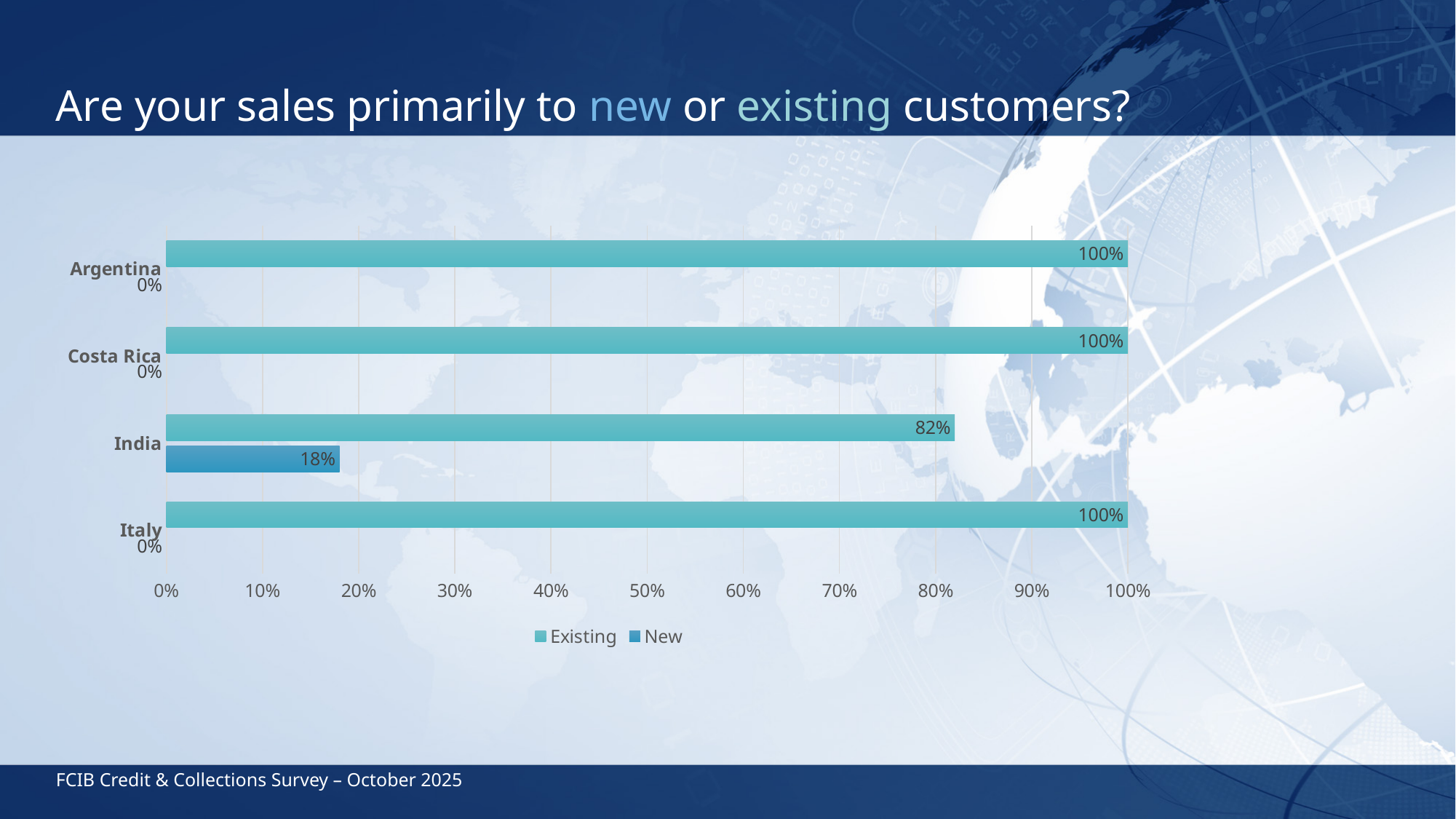
What is the Existing value for India? 82% What is the Existing value for Argentina? 100% What are the two series named in the legend? Existing and New Which country has the lowest Existing value? India What kind of chart is shown on the slide? bar chart How many countries are shown on the chart? 4 Which country has the highest New value? India How many series does the legend list? 2 Is the Existing value for India larger or smaller than the Existing value for Italy? smaller What is the New value for India? 18% What is the New value for Costa Rica? 0% What is the difference between the Existing and New values for India? 64%